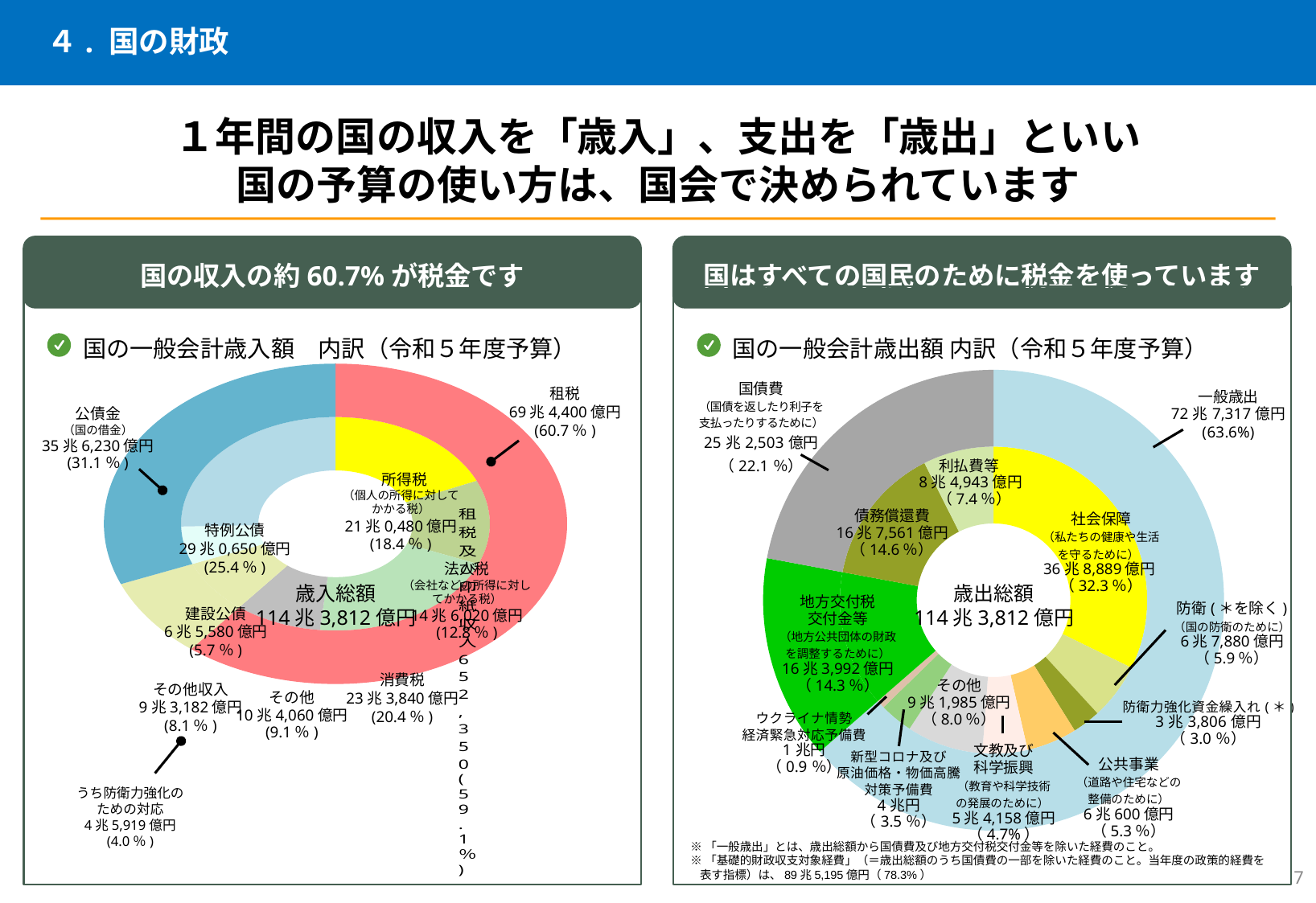
右の「国の一般会計歳出額 内訳」のグラフで、国債費の割合は何％ですか？ 22.1% 左の「国の一般会計歳入額 内訳」のグラフで、所得税と法人税ではどちらの金額が大きいですか？ 所得税 このスライドのグラフはどのような種類のグラフですか？ ドーナツ（円）グラフ 右の「国の一般会計歳出額 内訳」のグラフで、社会保障の金額はいくらですか？ 36兆8,889億円 左の「国の一般会計歳入額 内訳」のグラフで、租税の金額はいくらですか？ 69兆4,400億円 右の「国の一般会計歳出額 内訳」のグラフで、一般歳出の内訳のうち最も割合が大きい項目は何ですか？ 社会保障 左の「国の一般会計歳入額 内訳」のグラフで、特例公債と建設公債の割合の差は何ポイントですか？ 19.7ポイント 左の「国の一般会計歳入額 内訳」のグラフで、消費税の金額はいくらですか？ 23兆3,840億円 左の「国の一般会計歳入額 内訳」のグラフで、歳入総額はいくらですか？ 114兆3,812億円 右の「国の一般会計歳出額 内訳」のグラフで、地方交付税交付金等の金額はいくらですか？ 16兆3,992億円 左の「国の一般会計歳入額 内訳」のグラフで、公債金の割合は何％ですか？ 31.1% 右の「国の一般会計歳出額 内訳」のグラフで、公共事業と文教及び科学振興ではどちらの割合が大きいですか？ 公共事業